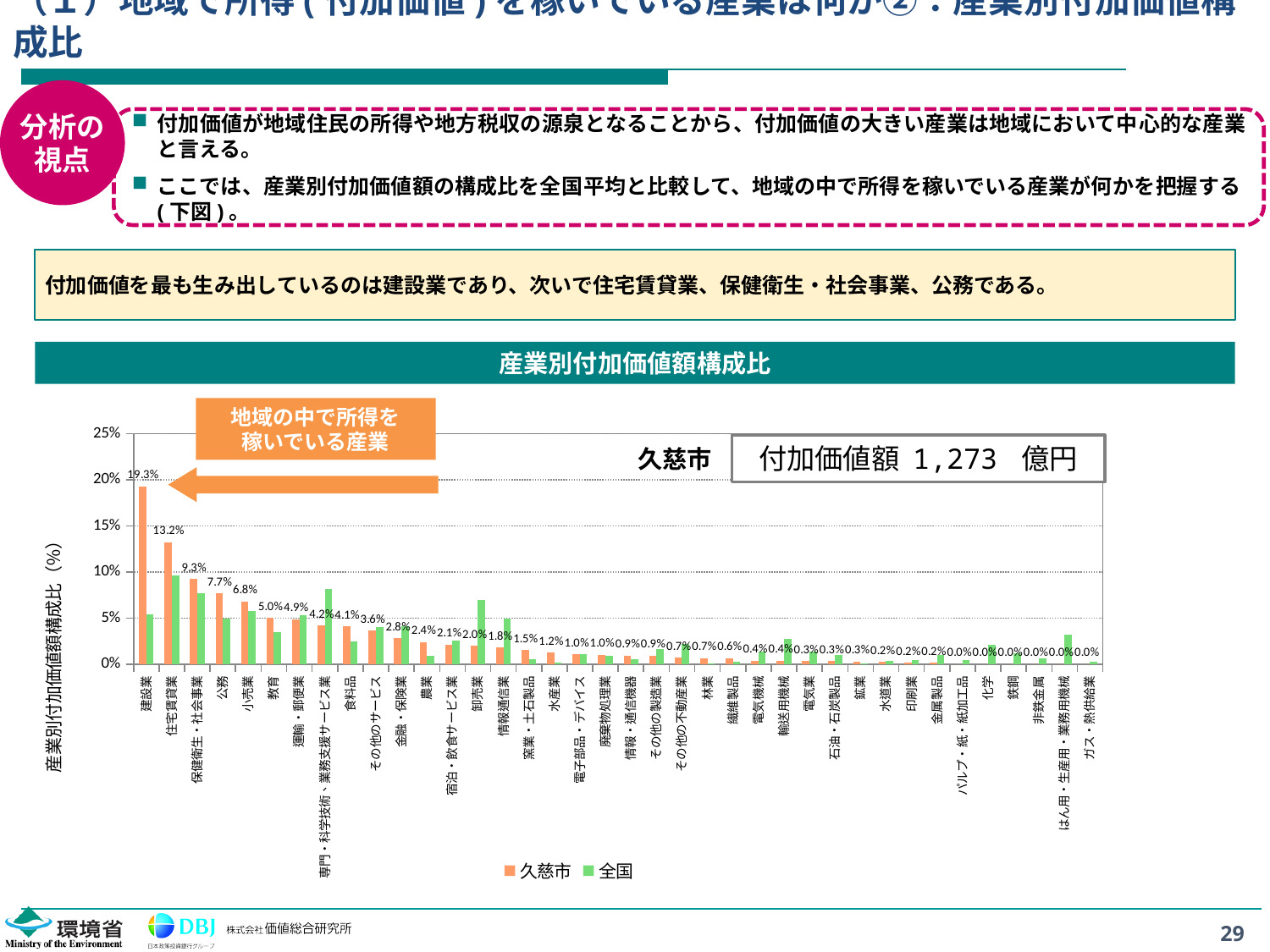
What is the 久慈市 value for 住宅賃貸業? 13.2% For 建設業, which series has the larger value, 久慈市 or 全国? 久慈市 Which industry has the highest 久慈市 value? 建設業 For 卸売業, which series has the larger value, 久慈市 or 全国? 全国 What is the 久慈市 value for 保健衛生・社会事業? 9.3% What is the 久慈市 value for 建設業? 19.3% What are the two series named in the chart legend? 久慈市 and 全国 What is the 久慈市 value for 小売業? 6.8% What is the difference between the 久慈市 values for 建設業 and 住宅賃貸業? 6.1% What kind of chart is shown under the heading 産業別付加価値額構成比? bar chart How many series does the chart legend list? 2 Is the 全国 value for 専門・科学技術、業務支援サービス業 greater or less than 5%? greater